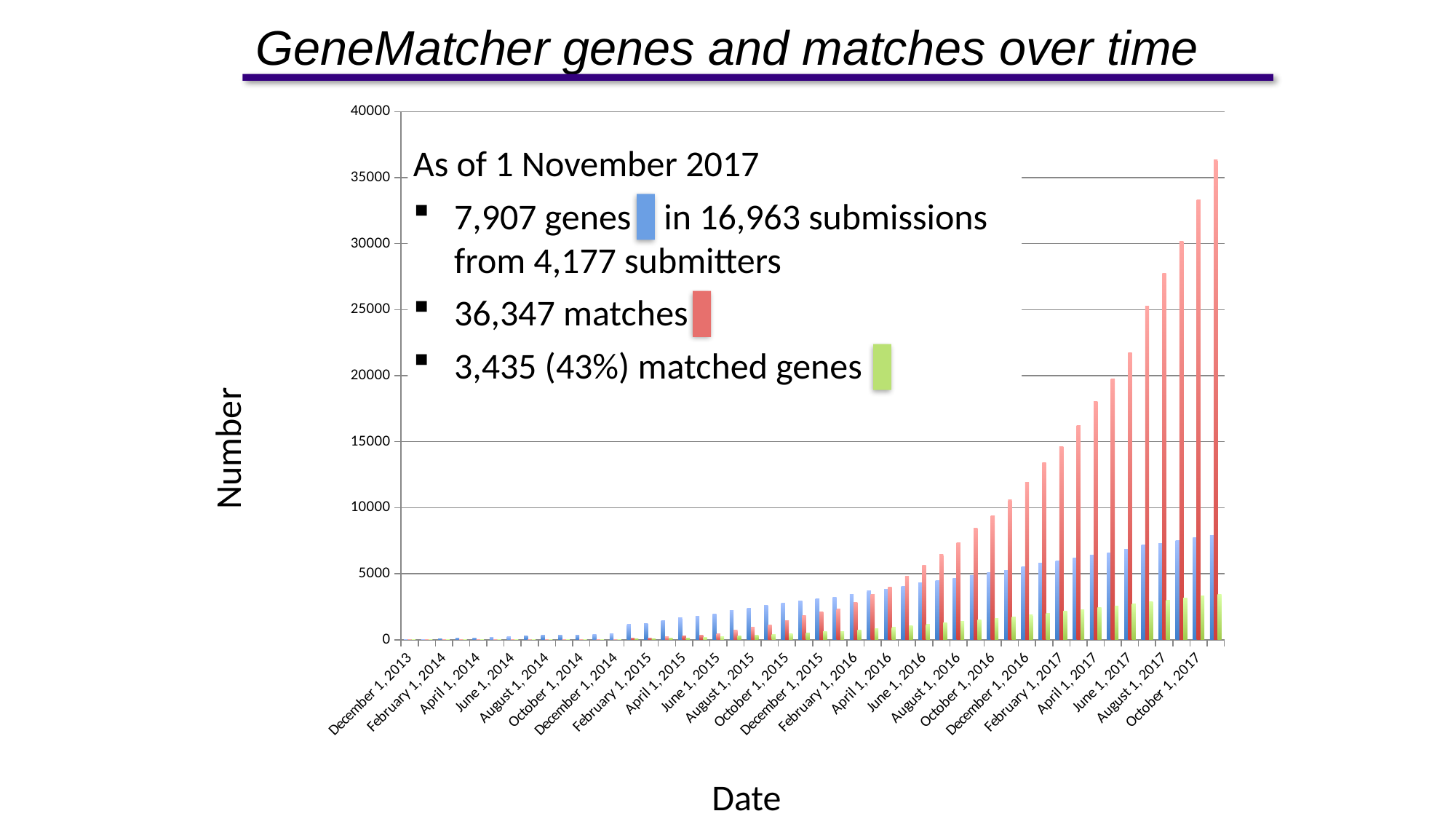
Is the value for matches at February 1, 2017 greater or less than 10000? greater What is the label of the vertical axis? Number Is the value for genes at October 1, 2017 greater or less than 10000? less Which series has the lowest value at October 1, 2017: genes, matches, or matched genes? matched genes At October 1, 2017, which is larger: the number of genes or the number of matches? matches Do the values for matches rise or fall over time along the x axis? rise How many data series are plotted in the chart? 3 What kind of chart is shown on the slide? bar chart What is the title of the chart? GeneMatcher genes and matches over time Which series has the highest value at October 1, 2017: genes, matches, or matched genes? matches Is the value for matches at October 1, 2017 greater or less than 30000? greater